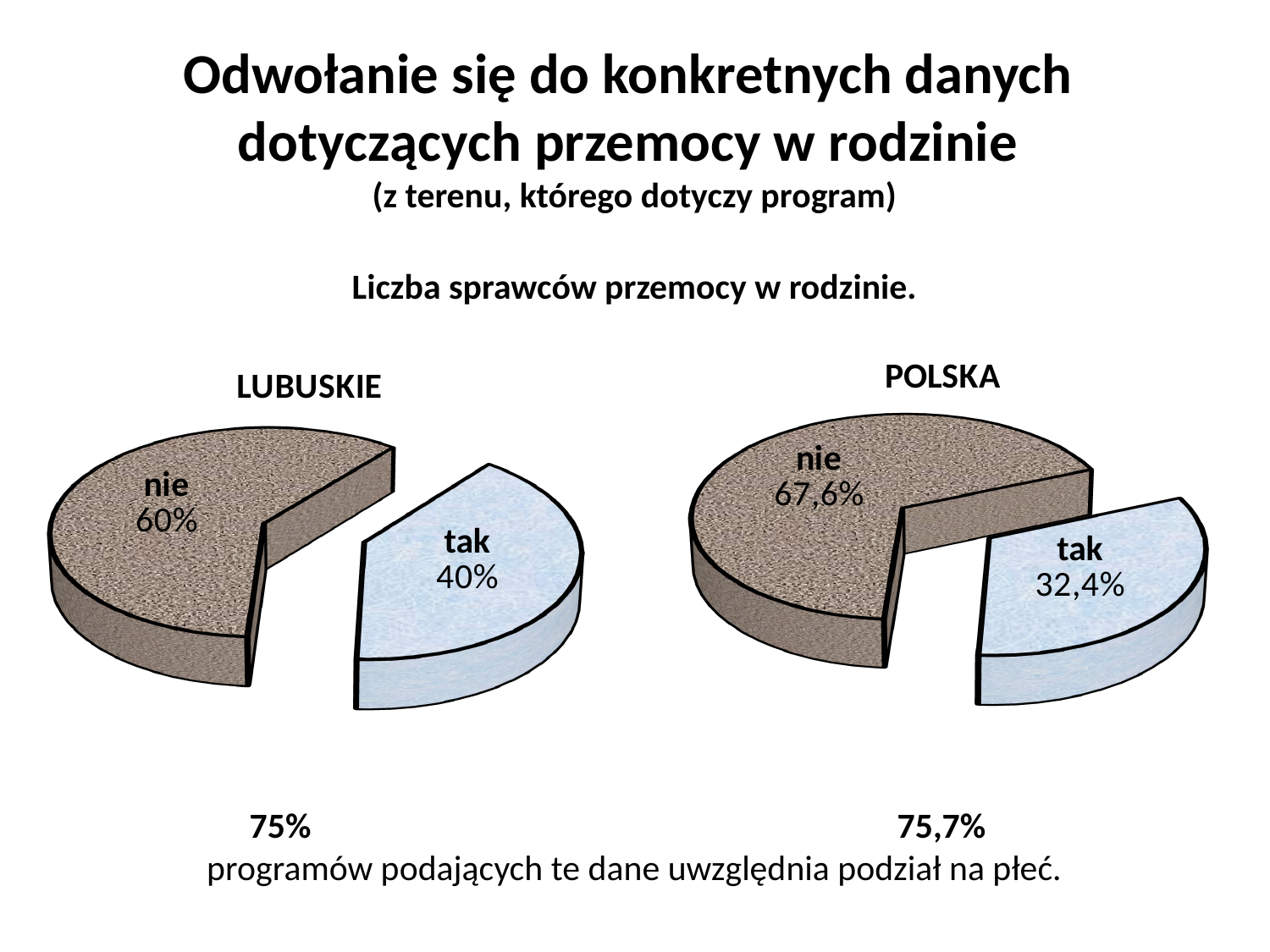
In the POLSKA pie chart, which slice is the smallest? tak What colour is the "tak" slice in the LUBUSKIE pie chart? Light blue What type of chart is used for LUBUSKIE? Pie chart In the POLSKA pie chart, what is the value for "nie"? 67,6% How many slices does the POLSKA pie chart have? 2 In the LUBUSKIE pie chart, what is the difference between the "nie" and "tak" slices? 20% In the POLSKA pie chart, what is the value for "tak"? 32,4% Is the "tak" share larger in the LUBUSKIE chart or in the POLSKA chart? LUBUSKIE In the LUBUSKIE pie chart, what is the value for "nie"? 60% In the LUBUSKIE pie chart, what is the value for "tak"? 40% In the POLSKA pie chart, what is the difference between the "nie" and "tak" slices? 35,2% In the LUBUSKIE pie chart, which slice is the largest? nie